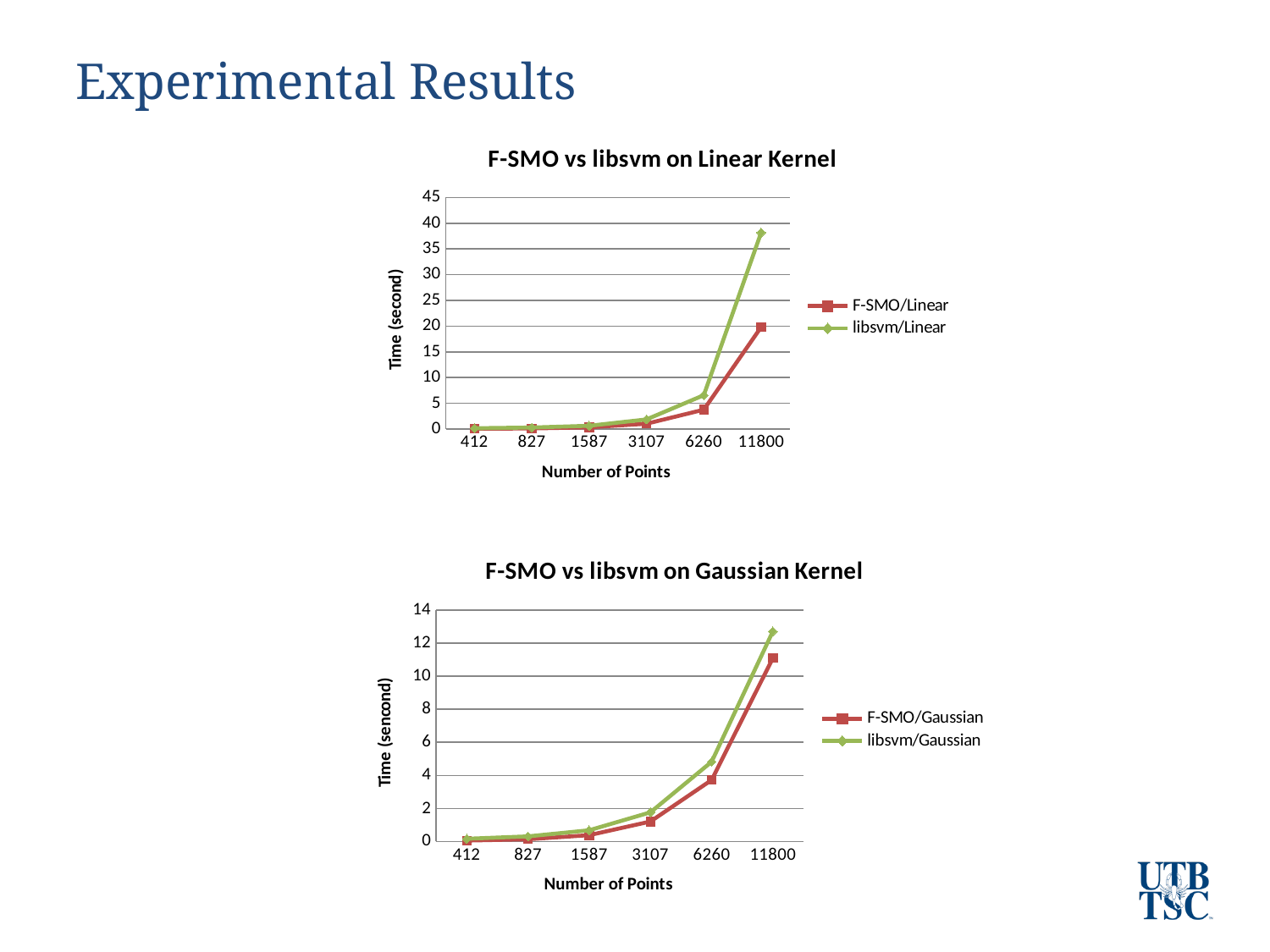
In the 'F-SMO vs libsvm on Gaussian Kernel' chart, is the value for libsvm/Gaussian at 11800 points greater or less than 12? greater In the 'F-SMO vs libsvm on Linear Kernel' chart, how many points are plotted along the x axis for each series? 6 In the 'F-SMO vs libsvm on Linear Kernel' chart, do the values rise or fall as the number of points increases? rise In the 'F-SMO vs libsvm on Linear Kernel' chart, is the value for F-SMO/Linear at 11800 points greater or less than 25? less In the 'F-SMO vs libsvm on Gaussian Kernel' chart, which series has the higher value at 11800 points? libsvm/Gaussian In the 'F-SMO vs libsvm on Linear Kernel' chart, which series has the higher value at 11800 points? libsvm/Linear In the 'F-SMO vs libsvm on Linear Kernel' chart, what kind of chart is shown? line chart In the 'F-SMO vs libsvm on Linear Kernel' chart, at which number of points does libsvm/Linear reach its highest value? 11800 In the 'F-SMO vs libsvm on Linear Kernel' chart, how many series does the legend list? 2 In the 'F-SMO vs libsvm on Gaussian Kernel' chart, what is the label of the y axis? Time (sencond) In the 'F-SMO vs libsvm on Linear Kernel' chart, is the value for libsvm/Linear at 11800 points greater or less than 35? greater